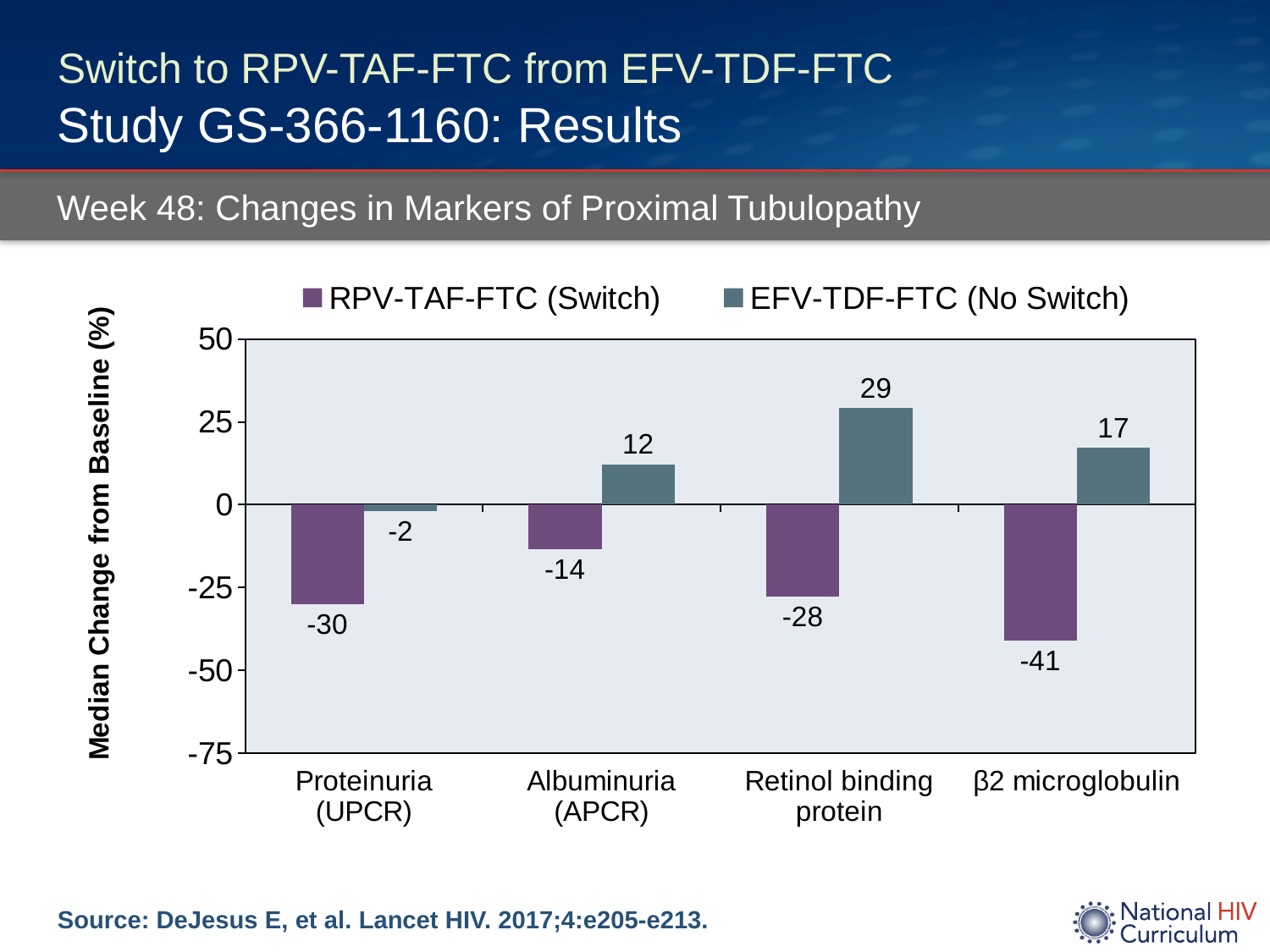
How many categories are shown on the x axis? 4 Which is larger for Albuminuria (APCR): the RPV-TAF-FTC (Switch) value or the EFV-TDF-FTC (No Switch) value? EFV-TDF-FTC (No Switch) What is the difference between the EFV-TDF-FTC (No Switch) and RPV-TAF-FTC (Switch) values for Retinol binding protein? 57 What is the value for RPV-TAF-FTC (Switch) in β2 microglobulin? -41 What is the median change from baseline for RPV-TAF-FTC (Switch) in Proteinuria (UPCR)? -30 What is the label of the y axis? Median Change from Baseline (%) Which category has the lowest value for RPV-TAF-FTC (Switch)? β2 microglobulin How many series does the legend list? 2 What is the value for EFV-TDF-FTC (No Switch) in Albuminuria (APCR)? 12 What kind of chart is shown on the slide? Bar chart What is the median change from baseline for EFV-TDF-FTC (No Switch) in Retinol binding protein? 29 Which category has the highest value for EFV-TDF-FTC (No Switch)? Retinol binding protein